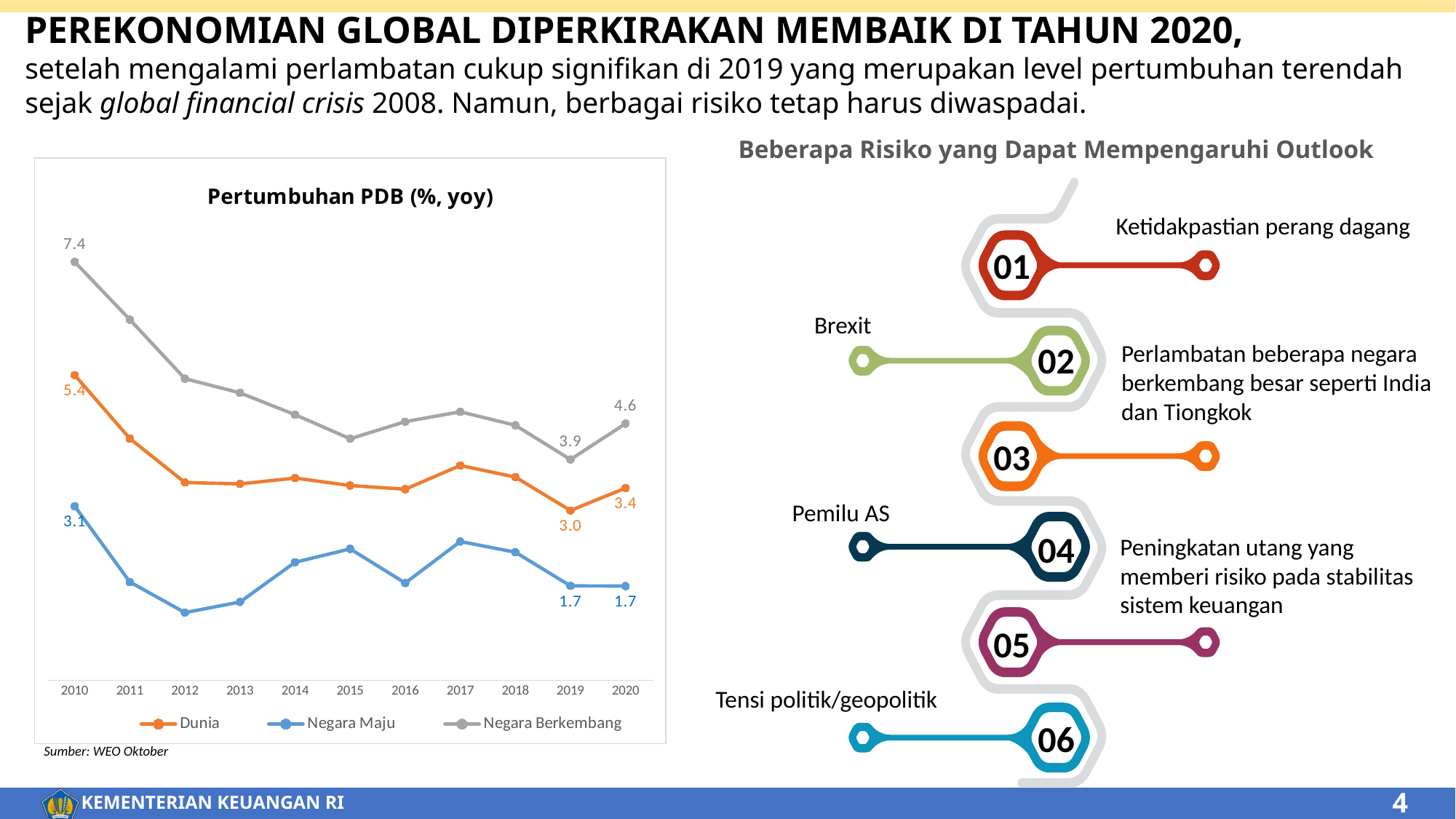
What is the value for Dunia in 2019 in the "Pertumbuhan PDB (%, yoy)" chart? 3.0 In the "Pertumbuhan PDB (%, yoy)" chart, does the Dunia series rise or fall from 2010 to 2019? fall What is the value for Negara Berkembang in 2020 in the "Pertumbuhan PDB (%, yoy)" chart? 4.6 In the "Pertumbuhan PDB (%, yoy)" chart, what is the difference between Negara Berkembang and Negara Maju in 2020? 2.9 In the "Pertumbuhan PDB (%, yoy)" chart, which series has the lowest value in 2019? Negara Maju What is the value for Negara Maju in 2020 in the "Pertumbuhan PDB (%, yoy)" chart? 1.7 In the "Pertumbuhan PDB (%, yoy)" chart, what is the difference between the Dunia values for 2010 and 2019? 2.4 How many years are shown on the x axis of the "Pertumbuhan PDB (%, yoy)" chart? 11 How many series does the legend of the "Pertumbuhan PDB (%, yoy)" chart list? 3 In the "Pertumbuhan PDB (%, yoy)" chart, which series has the highest value in 2010? Negara Berkembang What type of chart is shown under the title "Pertumbuhan PDB (%, yoy)"? line chart What is the value for Negara Berkembang in 2010 in the "Pertumbuhan PDB (%, yoy)" chart? 7.4